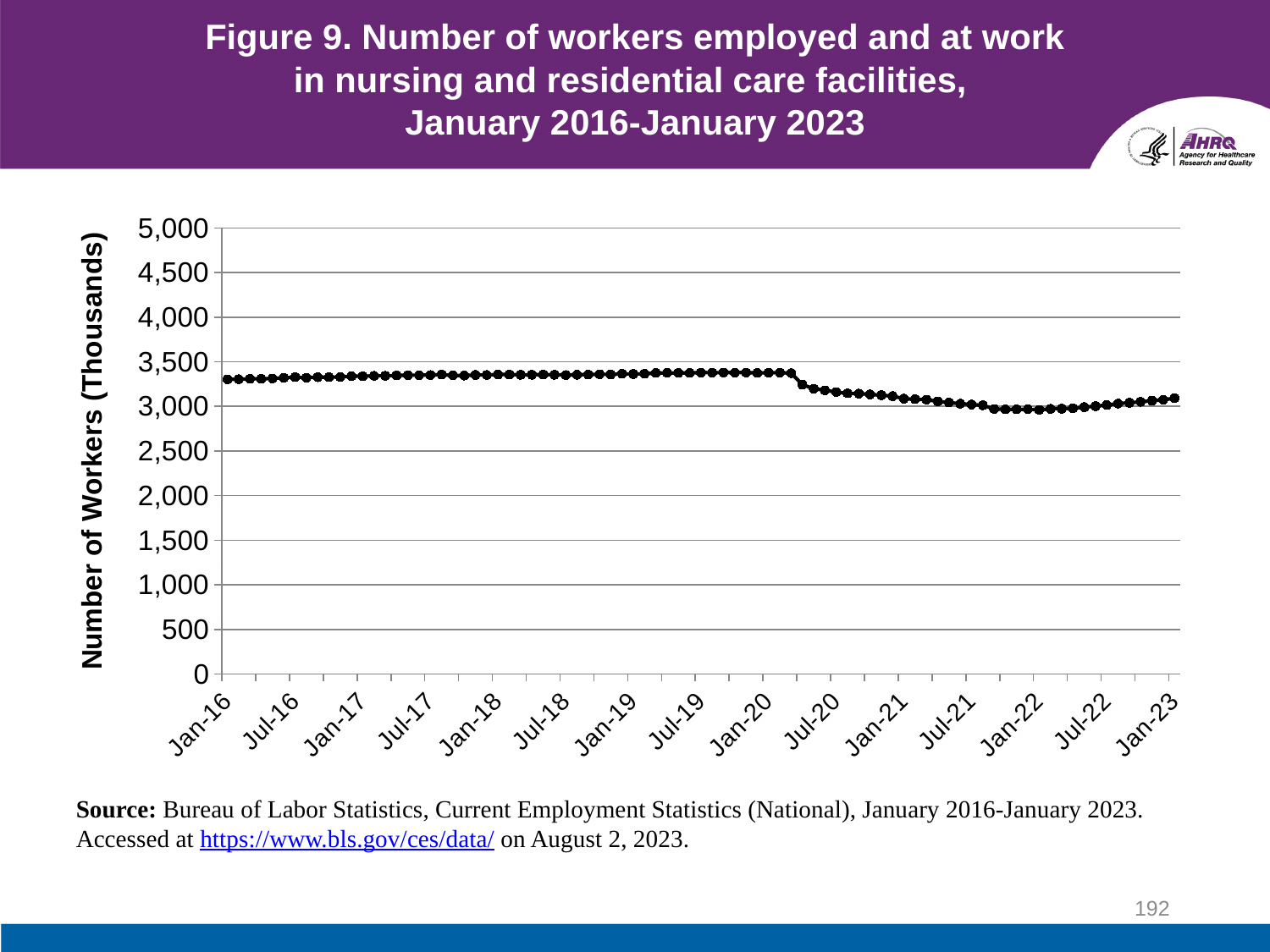
Is the value for Jan-16 greater or less than 3,500? less What is the label of the vertical axis? Number of Workers (Thousands) Between Jan-20 and Jul-20, do the values rise or fall? fall How many date labels are shown on the x axis? 15 Is the value for Jan-20 greater or less than 3,000? greater Is the value for Jan-23 greater or less than 2,500? greater Which is larger, the value for Jan-20 or the value for Jan-22? Jan-20 Between Jan-22 and Jan-23, do the values rise or fall? rise What kind of chart is shown on the slide? Line chart